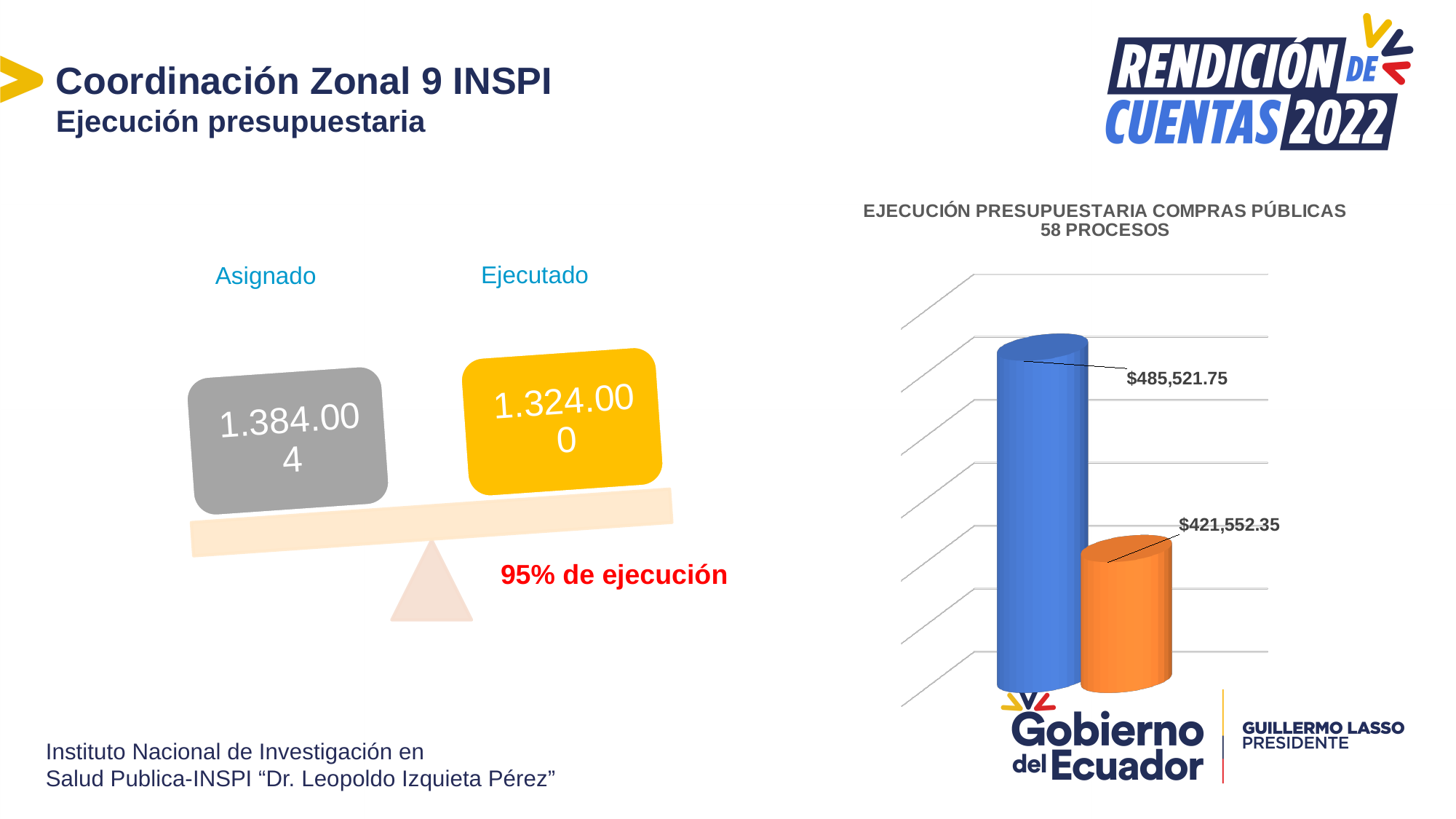
How many bars are plotted in the chart titled "EJECUCIÓN PRESUPUESTARIA COMPRAS PÚBLICAS 58 PROCESOS"? 2 How many processes does the title of the chart on the right mention? 58 What kind of chart is shown on the right side of the slide? bar chart In the chart on the right, which bar has the lowest value? the orange bar In the chart on the right, is the blue bar or the orange bar larger? the blue bar In the chart on the right, which bar has the highest value? the blue bar In the chart on the right, what is the difference between the blue bar value and the orange bar value? $63,969.40 In the chart on the right, do the bar values rise or fall from left to right? fall In the chart on the right, what value is labelled on the orange bar? $421,552.35 In the chart on the right, what value is labelled on the blue bar? $485,521.75 What is the title of the chart on the right side of the slide? EJECUCIÓN PRESUPUESTARIA COMPRAS PÚBLICAS 58 PROCESOS